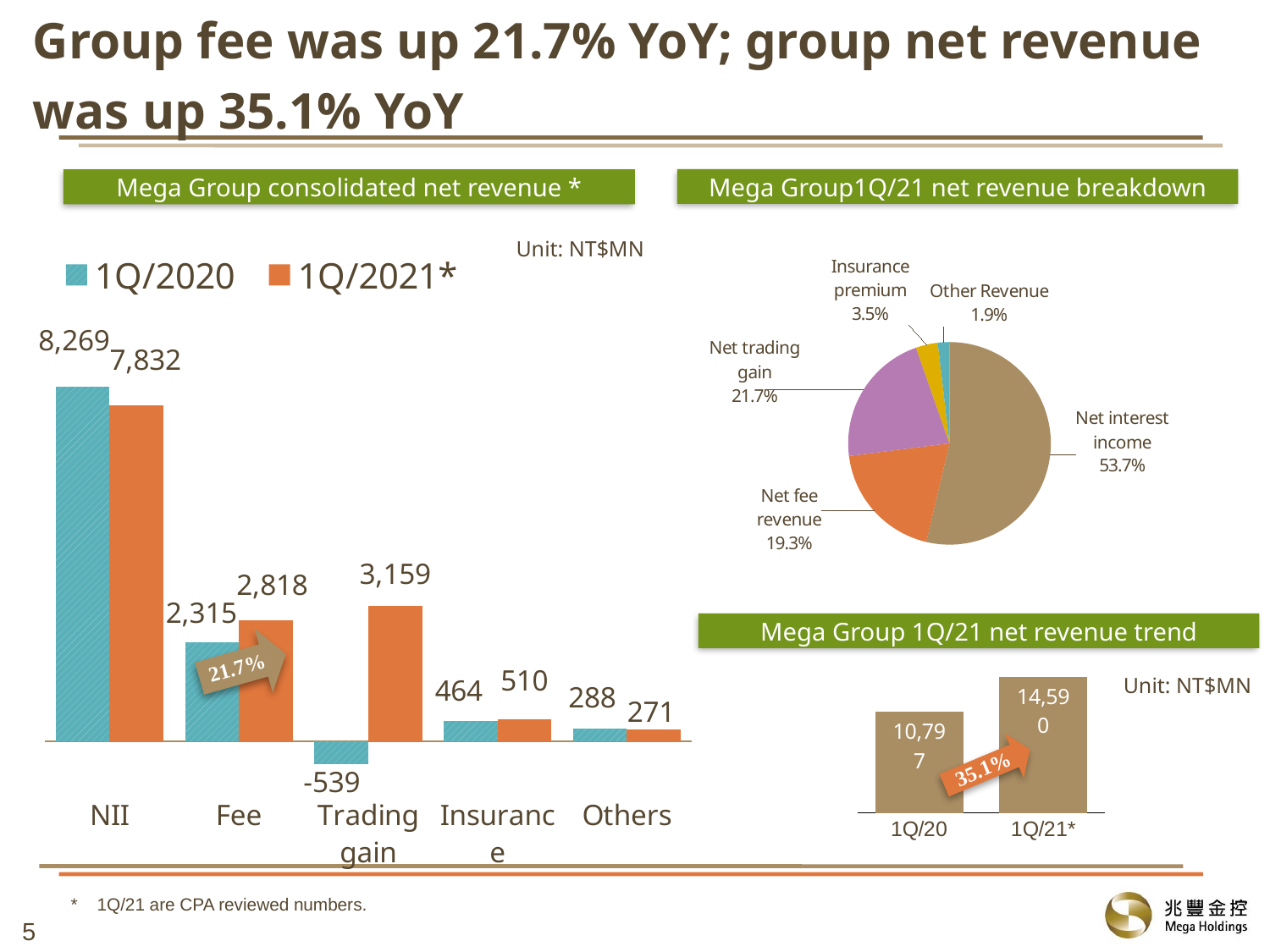
In the 'Mega Group1Q/21 net revenue breakdown' pie chart, what share is Net trading gain? 21.7% In the 'Mega Group consolidated net revenue' chart, is the Others value larger in 1Q/2020 or 1Q/2021*? 1Q/2020 In the 'Mega Group consolidated net revenue' chart, what is the NII value for 1Q/2020? 8,269 In the 'Mega Group consolidated net revenue' chart, what is the Trading gain value for 1Q/2021*? 3,159 In the 'Mega Group consolidated net revenue' chart, which category has the lowest 1Q/2020 value? Trading gain How many series does the legend of the 'Mega Group consolidated net revenue' chart list? 2 How many categories are shown on the x axis of the 'Mega Group consolidated net revenue' chart? 5 In the 'Mega Group1Q/21 net revenue breakdown' pie chart, which slice is the largest? Net interest income In the 'Mega Group consolidated net revenue' chart, what is the Fee value for 1Q/2020? 2,315 In the 'Mega Group consolidated net revenue' chart, what is the difference between the 1Q/2021* and 1Q/2020 Fee values? 503 What kind of chart is 'Mega Group 1Q/21 net revenue trend'? Bar chart In the 'Mega Group 1Q/21 net revenue trend' chart, what is the value for 1Q/21*? 14,590